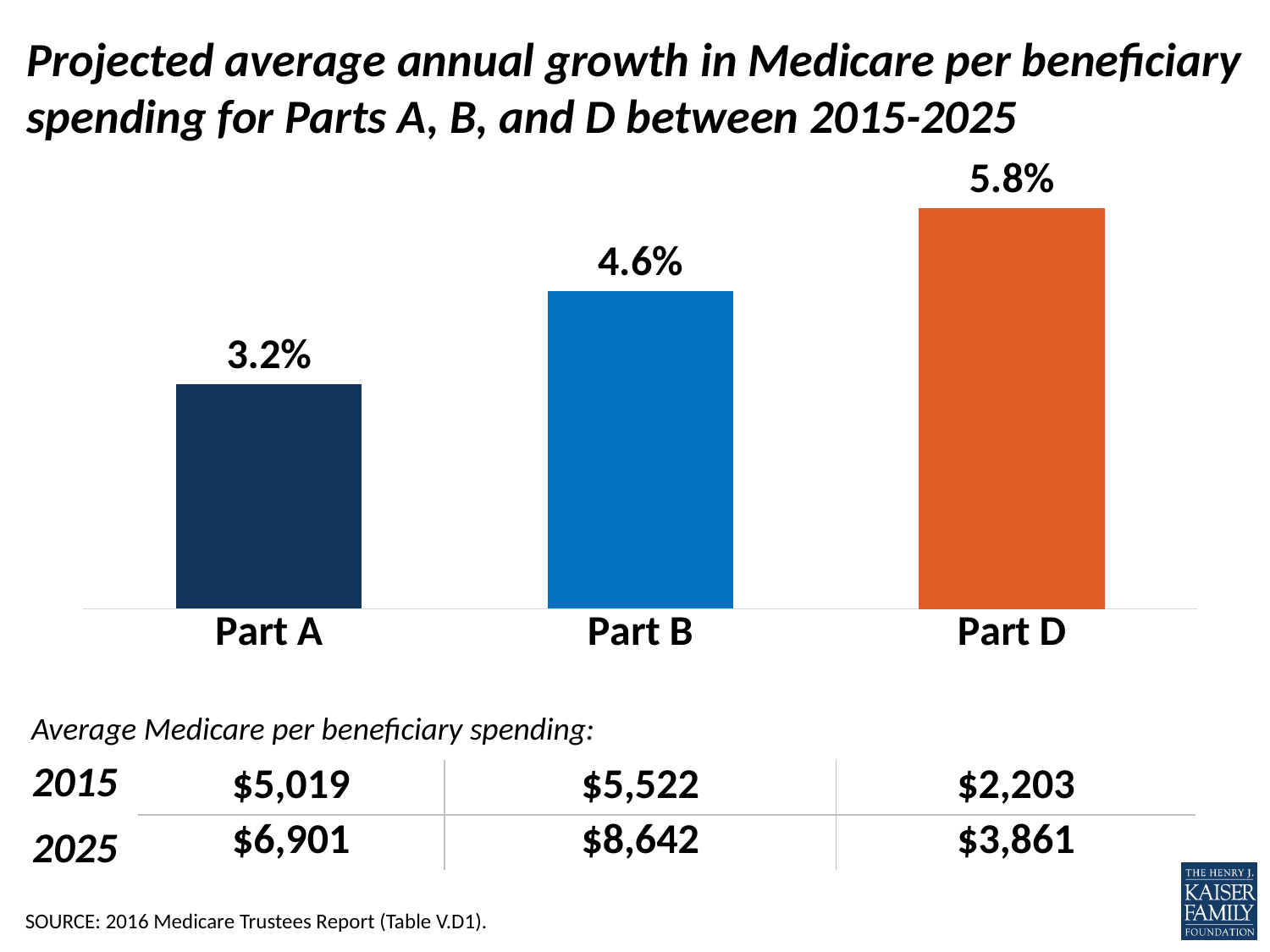
Which has a higher projected average annual growth rate, Part B or Part D? Part D Do the projected growth rates rise or fall moving from Part A to Part D along the x axis? Rise Which Medicare part has the lowest projected average annual growth in per beneficiary spending? Part A What is the difference in projected average annual growth between Part B and Part A? 1.4 percentage points What colour is the bar for Part D? Orange What type of chart is used to show the projected growth rates? Bar chart What is the projected average annual growth in per beneficiary spending for Part D? 5.8% What is the projected average annual growth in per beneficiary spending for Part A? 3.2% What is the difference in projected average annual growth between Part D and Part A? 2.6 percentage points Which Medicare part has the highest projected average annual growth in per beneficiary spending? Part D How many Medicare parts are shown as bars in the chart? 3 What is the projected average annual growth in per beneficiary spending for Part B? 4.6%